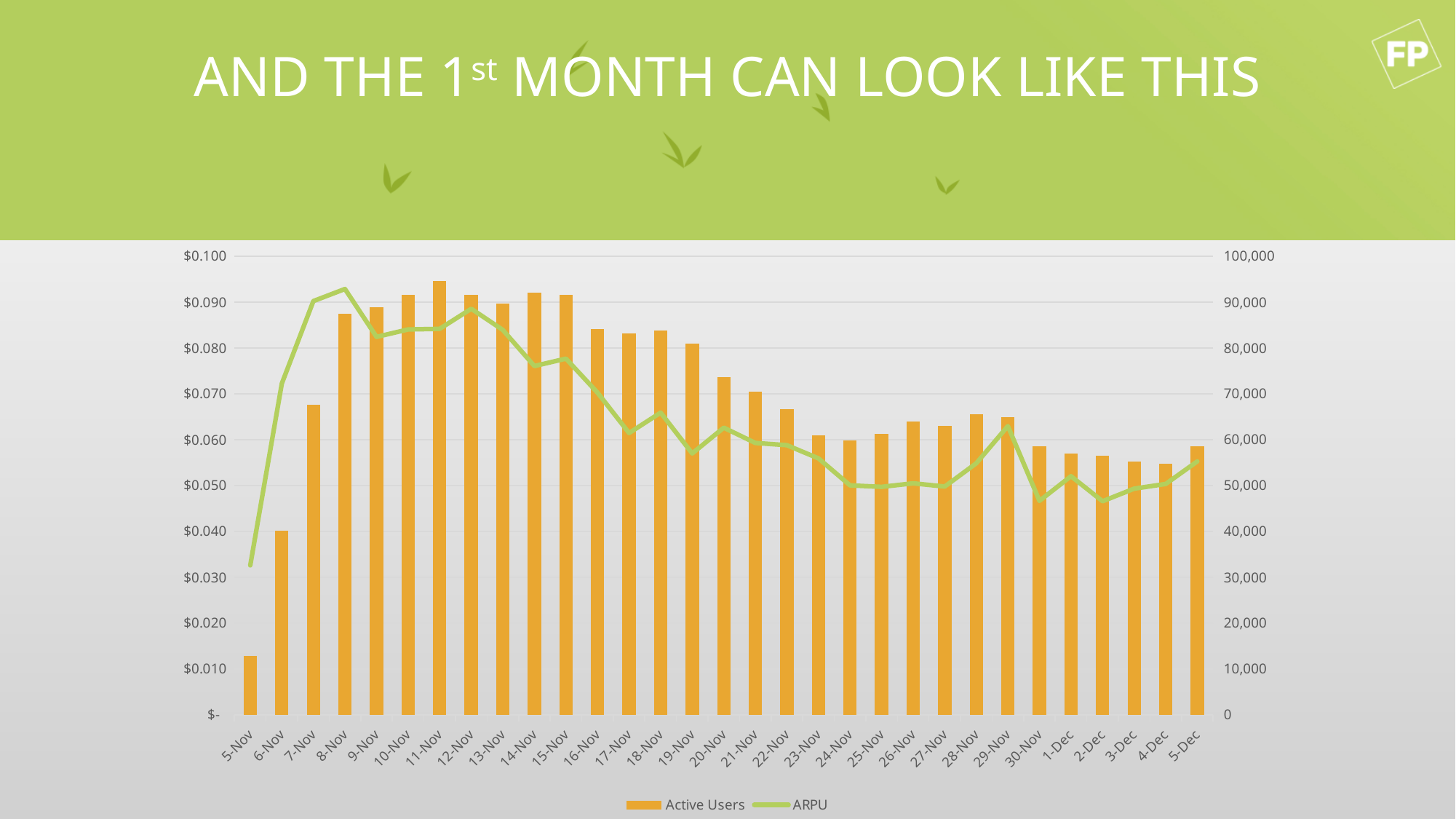
Is the Active Users value for 7-Nov greater or less than 60,000? greater How many dates are shown along the x axis? 31 On which date does the ARPU line reach its highest point? 8-Nov Is the ARPU value for 30-Nov greater or less than $0.050? less Do Active Users rise or fall from 15-Nov to 25-Nov? fall On which date is the ARPU line at its lowest point? 5-Nov On which date is the Active Users bar lowest? 5-Nov How many series does the legend list? 2 On which date is the Active Users bar highest? 11-Nov What are the two series named in the legend? Active Users and ARPU Which date has more Active Users, 16-Nov or 20-Nov? 16-Nov What kind of chart is shown on the slide? A combined bar and line chart